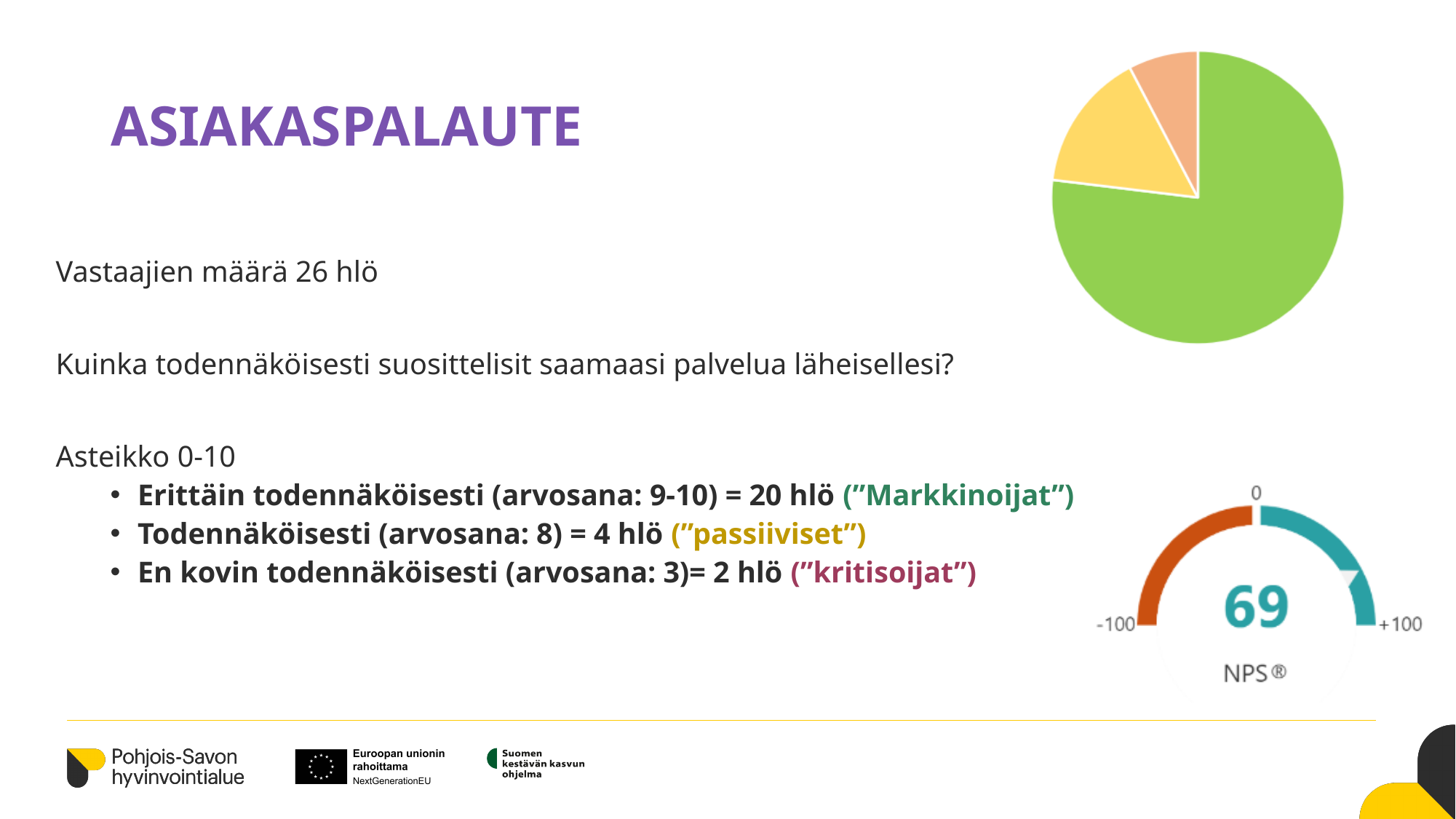
In the pie chart at the top right, is the yellow slice larger or smaller than the orange slice? larger In the pie chart at the top right, is the green slice larger or smaller than the yellow slice? larger What is the maximum value shown on the NPS gauge scale? +100 Is the value shown on the NPS gauge greater or less than 100? less What kind of chart is shown at the top right of the slide? pie chart How many slices does the pie chart at the top right have? 3 Is the value shown on the NPS gauge greater or less than 0? greater In the pie chart at the top right, which colour slice is the smallest? orange What value does the NPS gauge at the bottom right display? 69 What is the minimum value shown on the NPS gauge scale? -100 In the pie chart at the top right, which colour slice is the largest? green